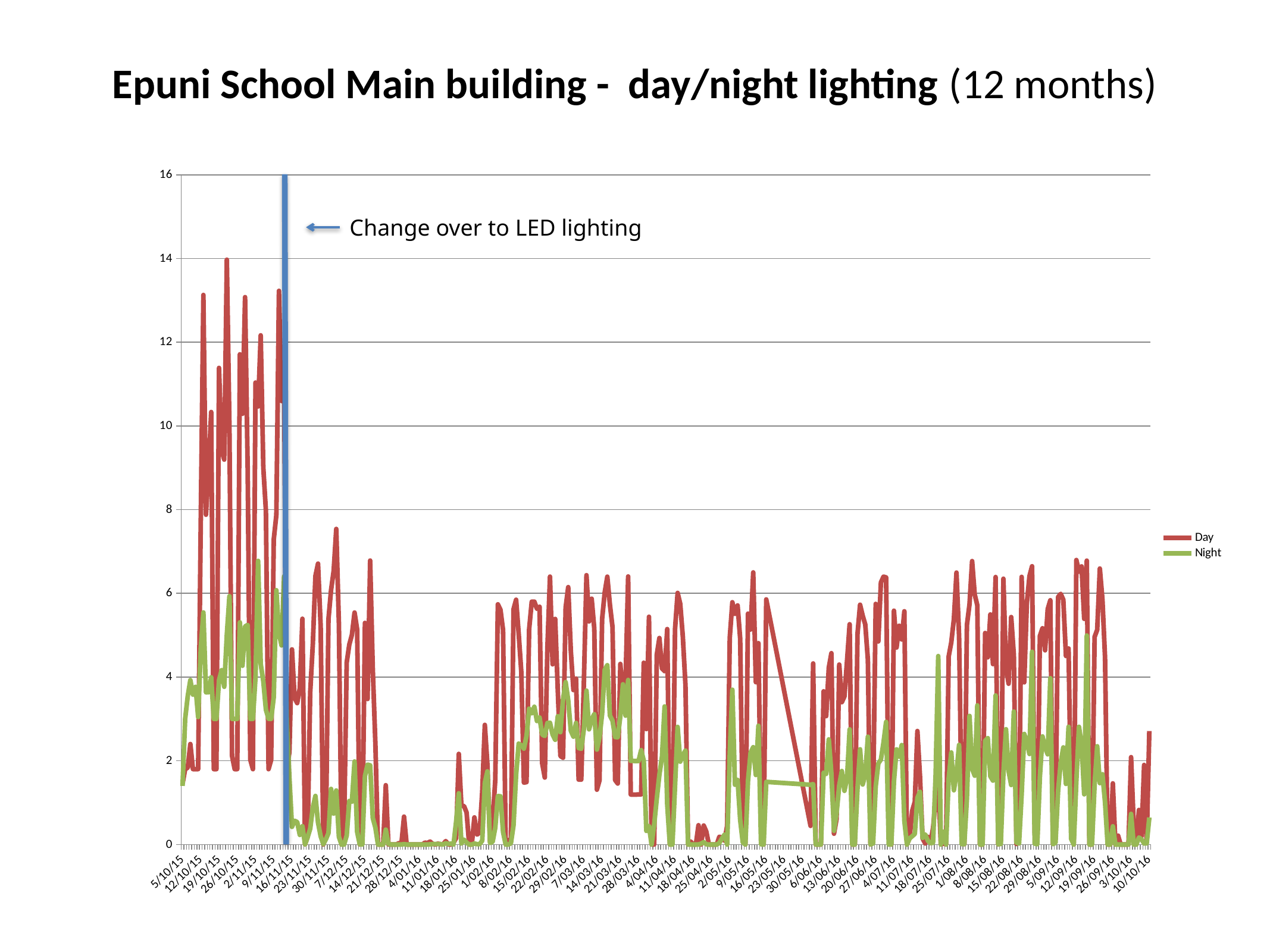
Do the Day values rise or fall immediately after the change over to LED lighting? fall Which series, Day or Night, generally has the higher values across the chart? Day What is the highest value shown on the y axis? 16 Is the highest Night value on the chart greater or less than 8? less What does the annotation next to the vertical blue line say? Change over to LED lighting What is the first date label on the x axis? 5/10/15 How many series does the legend list? 2 Is the highest Day value after the change over to LED lighting greater or less than 8? less What is the last date label on the x axis? 10/10/16 Is the highest Day value before the change over to LED lighting greater or less than 12? greater What are the two series named in the legend? Day and Night What kind of chart is shown on the slide? line chart